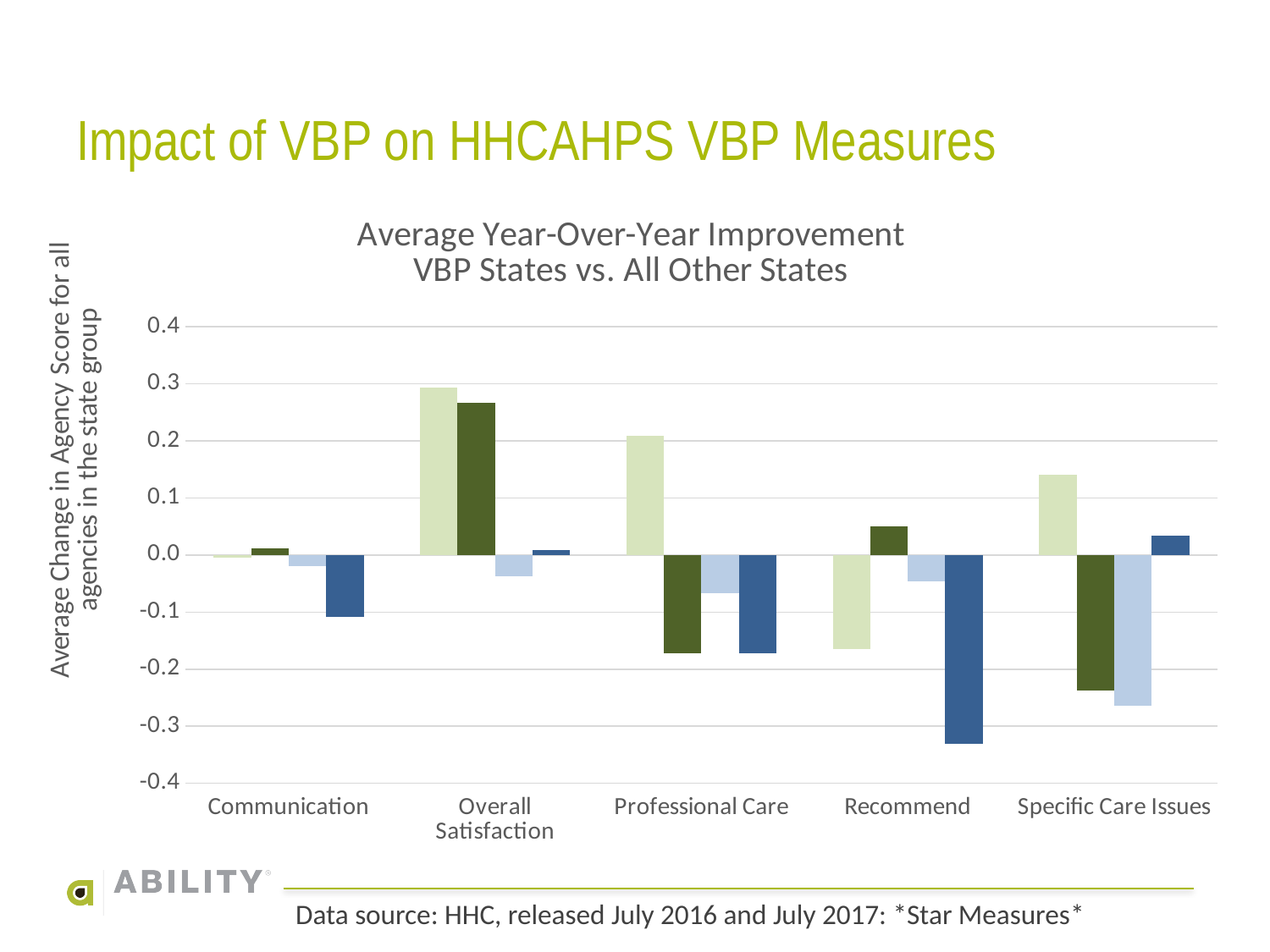
Which is larger, the light green bar for Professional Care or the light green bar for Specific Care Issues? Professional Care Is the value of the light blue bar for Specific Care Issues greater or less than -0.2? less Which category has the lowest dark blue bar? Recommend What kind of chart is shown on the slide? bar chart What is the label on the vertical axis of the chart? Average Change in Agency Score for all agencies in the state group What is the title of the chart? Average Year-Over-Year Improvement VBP States vs. All Other States How many bars are plotted for each category in the chart? 4 Is the value of the dark green bar for Specific Care Issues greater or less than -0.2? less Which category has the tallest light green bar? Overall Satisfaction How many categories are shown on the x axis of the chart? 5 Is the value of the dark blue bar for Recommend greater or less than -0.2? less